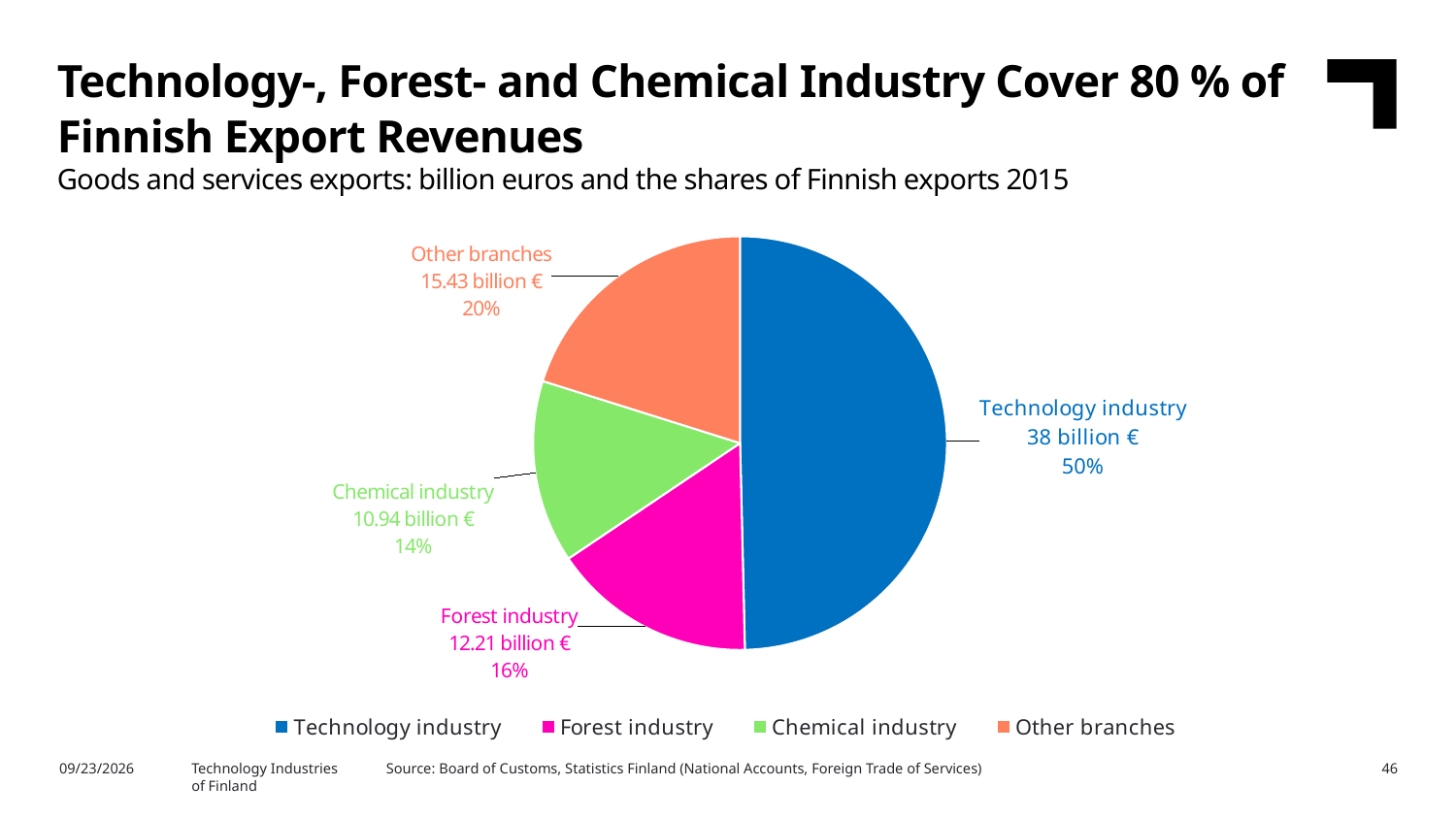
Which is larger, the export value for Other branches or for the Forest industry? Other branches What is the export value for the Forest industry? 12.21 billion € Which category has the smallest slice of the pie? Chemical industry What share of Finnish exports does the Technology industry account for? 50% What is the export value for the Chemical industry? 10.94 billion € What kind of chart is shown on the slide? pie chart What is the difference in export value between the Forest industry and the Chemical industry? 1.27 billion € How many categories does the legend list? 4 Which category has the largest slice of the pie? Technology industry What share of Finnish exports does the Chemical industry account for? 14% What is the export value for the Technology industry? 38 billion € What is the export value for Other branches? 15.43 billion €